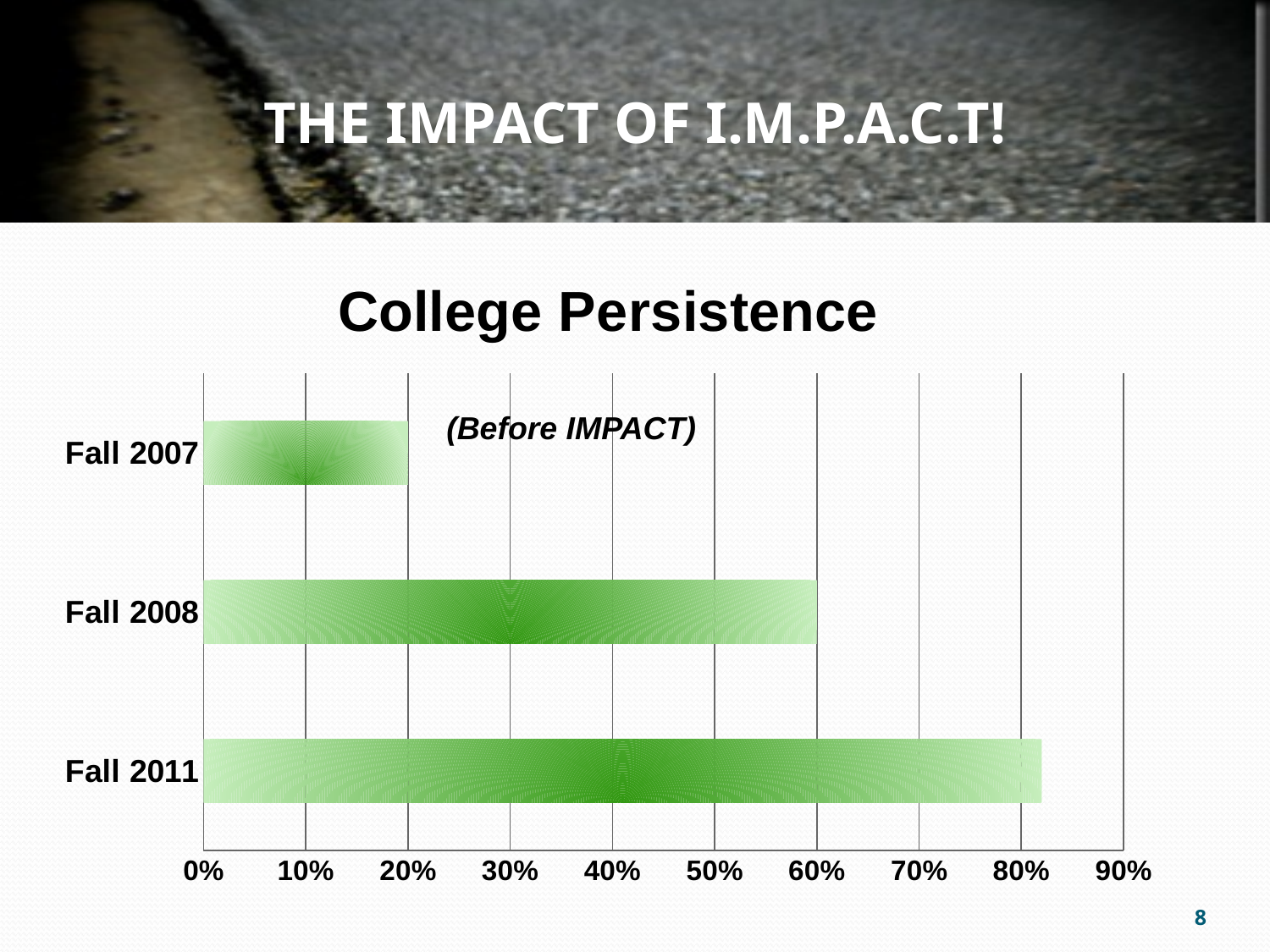
What type of chart is shown on the slide? bar chart Is the value for Fall 2011 greater or less than 90%? less Which category has the lowest college persistence value? Fall 2007 What is the difference between the Fall 2008 and Fall 2007 values? 40% Which category has the highest college persistence value? Fall 2011 What is the college persistence value for Fall 2007? 20% What is the college persistence value for Fall 2008? 60% Is the value for Fall 2011 greater or less than 80%? greater Which is larger, the value for Fall 2008 or the value for Fall 2007? Fall 2008 How many categories are plotted in the College Persistence chart? 3 Which category is annotated with the label '(Before IMPACT)'? Fall 2007 What is the title of the chart? College Persistence